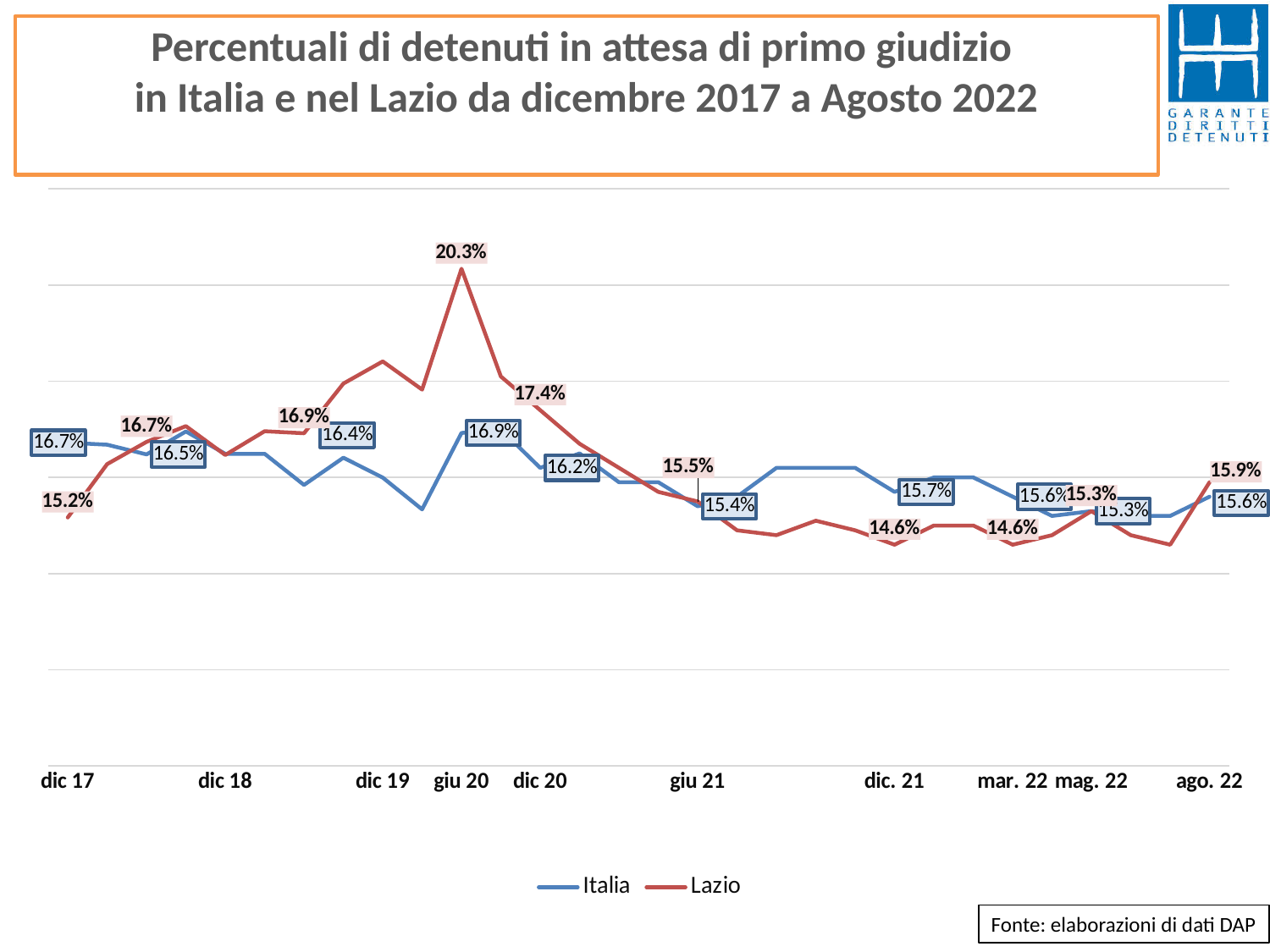
Which two series are shown in the legend? Italia and Lazio What kind of chart is shown on the slide? line chart How many series does the legend list? 2 What is the value for Lazio at dic 20? 17.4% What is the value for Lazio at ago. 22? 15.9% What is the value for Italia at ago. 22? 15.6% What is the value for Italia at giu 20? 16.9% Which series has the higher value at dic. 21, Italia or Lazio? Italia What is the lowest labelled value for Lazio? 14.6% What is the highest labelled value for Lazio? 20.3% What is the difference between Lazio and Italia at giu 20? 3.4% At which date does the Lazio series reach its peak of 20.3%? giu 20